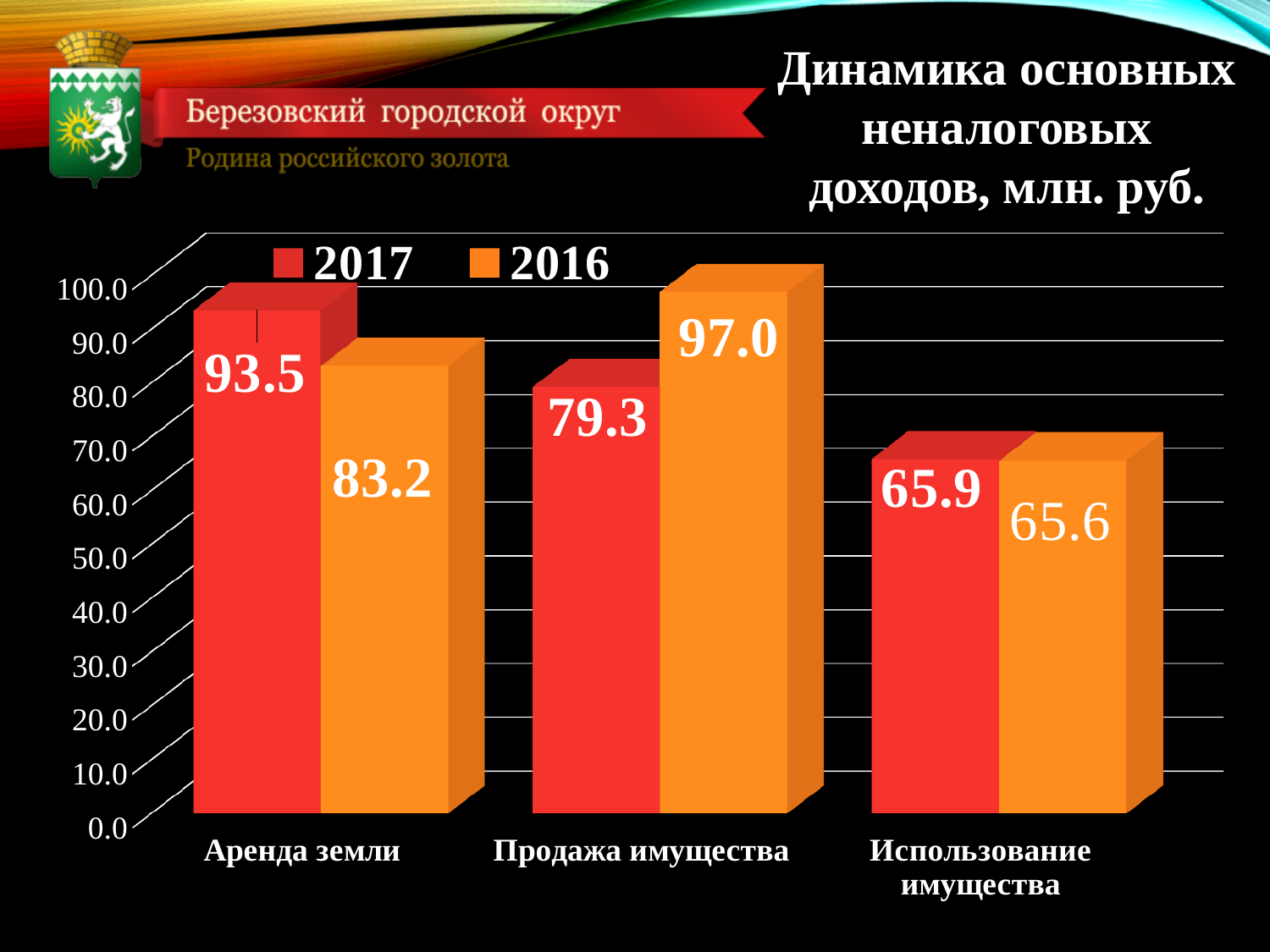
What is the 2016 value for Продажа имущества? 97.0 What is the 2016 value for Использование имущества? 65.6 For Аренда земли, which year has the larger value, 2017 or 2016? 2017 What is the difference between the 2017 and 2016 values for Аренда земли? 10.3 Which category has the lowest 2016 value? Использование имущества What type of chart is shown on the slide? Bar chart What is the difference between the 2016 and 2017 values for Продажа имущества? 17.7 How many series does the legend list? 2 What is the 2017 value for Продажа имущества? 79.3 Which category has the highest 2017 value? Аренда земли What is the 2017 value for Аренда земли? 93.5 How many categories are shown on the x axis? 3